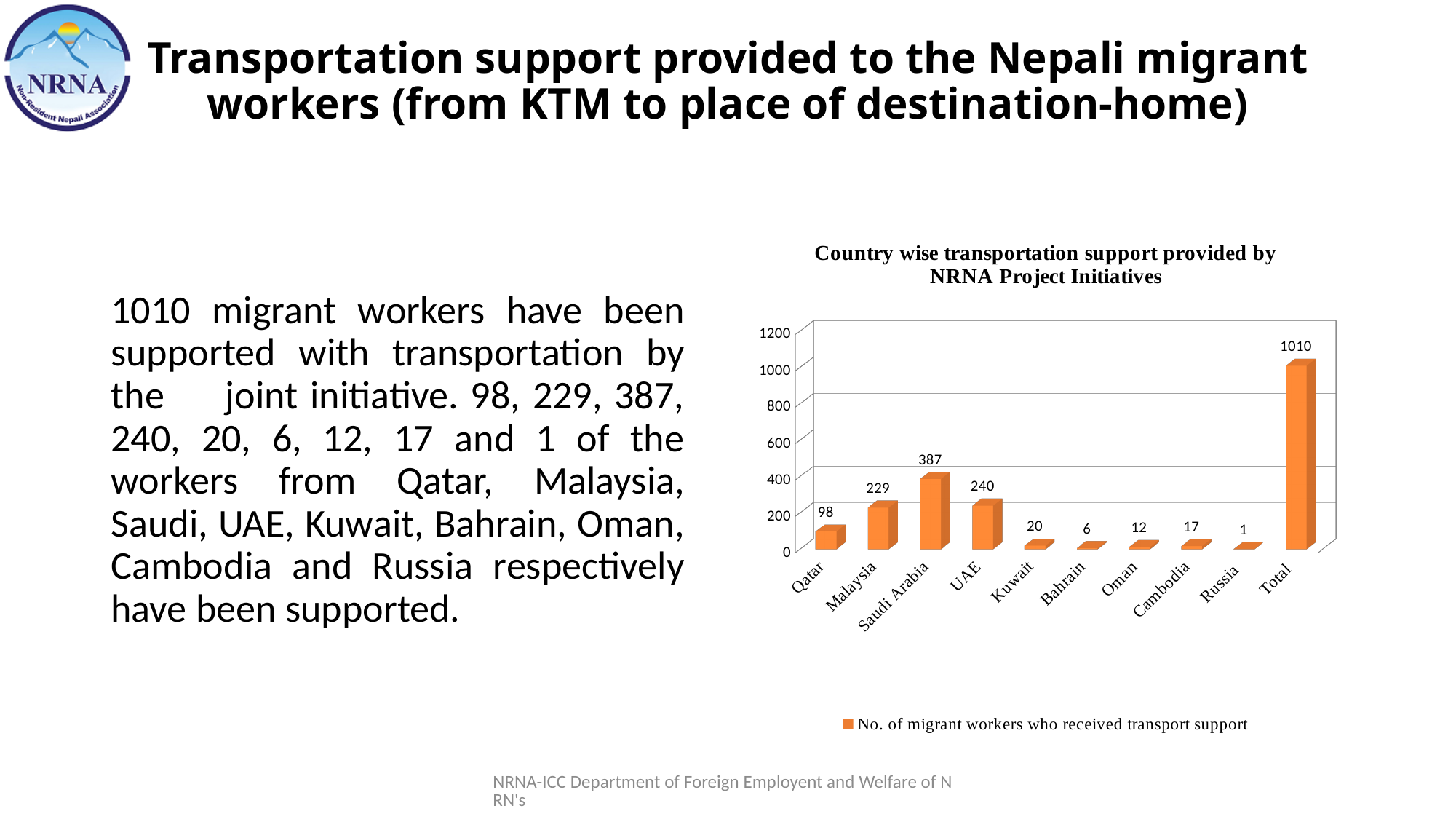
What is the title of the chart? Country wise transportation support provided by NRNA Project Initiatives What is the value for Saudi Arabia? 387 Which is larger, the value for Qatar or the value for Malaysia? Malaysia Which category has the lowest value? Russia How many series does the legend list? 1 What is the value for Malaysia? 229 What is the value for Russia? 1 What is the value for the Total bar? 1010 How many categories are shown on the x axis? 10 What is the difference between the values for Saudi Arabia and UAE? 147 Excluding the Total bar, which country has the highest value? Saudi Arabia What kind of chart is shown? Bar chart